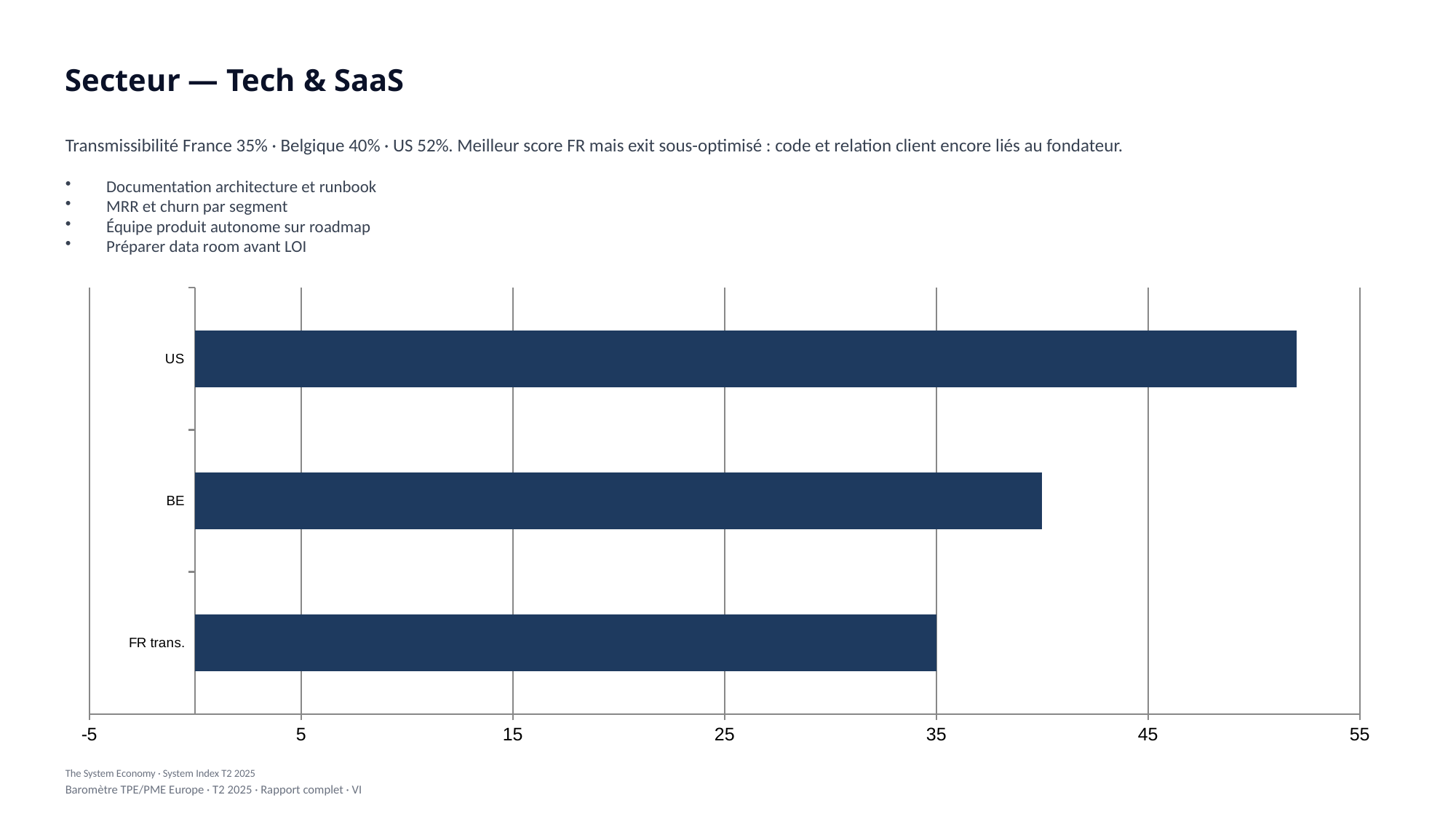
What is the value for FR trans. in the chart? 35 Which category has the highest value in the chart? US Is the value for US greater or less than 45? greater Which category has the lowest value in the chart? FR trans. Is the value for US greater or less than 55? less What is the highest tick label shown on the horizontal axis of the chart? 55 What kind of chart is shown on the slide? bar chart Is the value for BE greater or less than 35? greater How many categories are plotted in the chart? 3 Which is larger, the value for BE or the value for FR trans.? BE Which is larger, the value for US or the value for BE? US